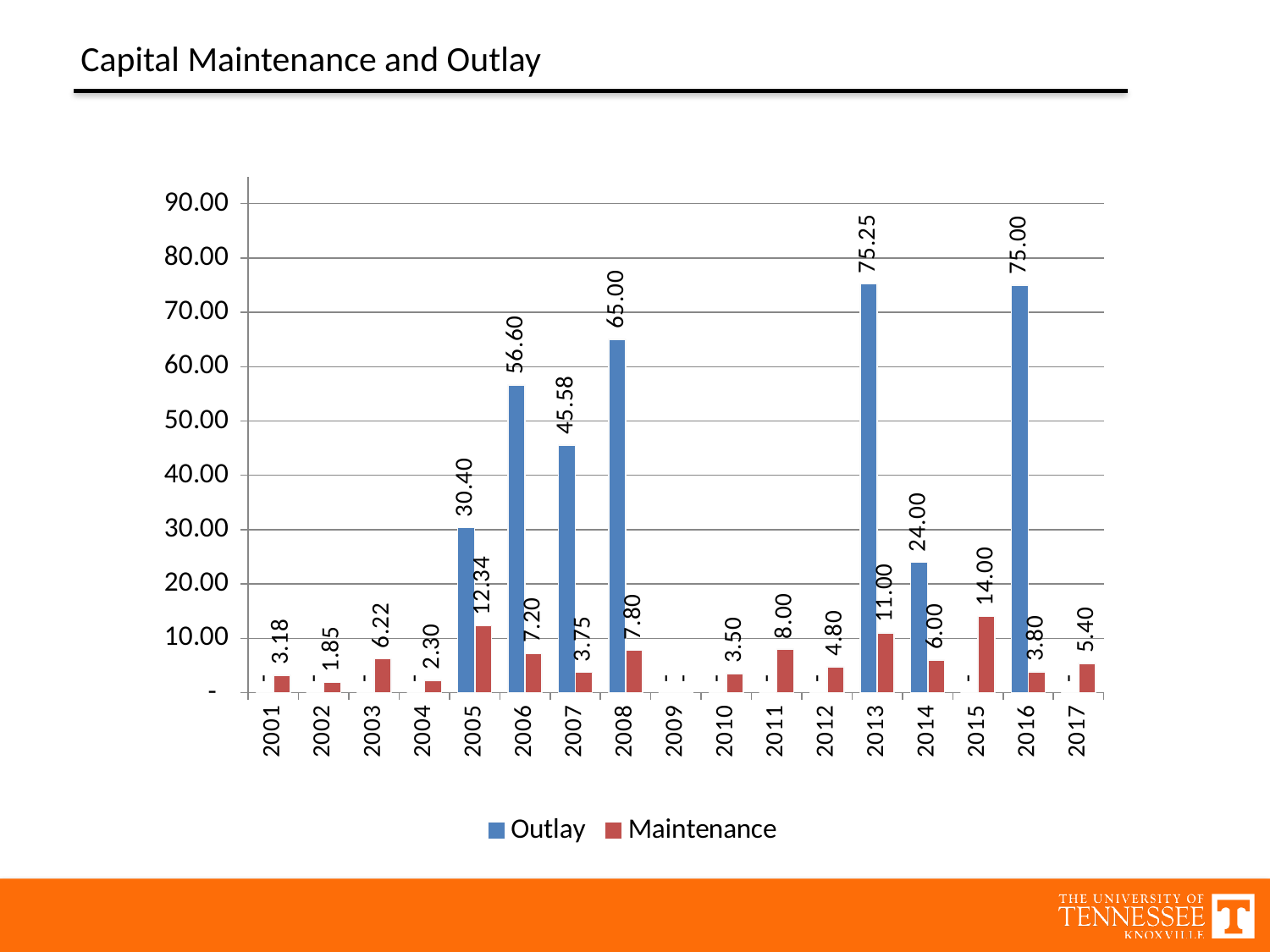
What kind of chart is shown on the slide? bar chart What is the difference between the Maintenance values for 2015 and 2005? 1.66 How many series does the legend list? 2 Which year has the highest Outlay value? 2013 What is the difference between the Outlay values for 2013 and 2016? 0.25 What is the Outlay value for 2008? 65.00 What is the Maintenance value for 2005? 12.34 Which year has the highest Maintenance value? 2015 What is the Maintenance value for 2017? 5.40 How many years are shown on the x axis? 17 Which is larger, the Outlay value for 2006 or for 2007? 2006 Is the Outlay value for 2005 greater or less than 40.00? less